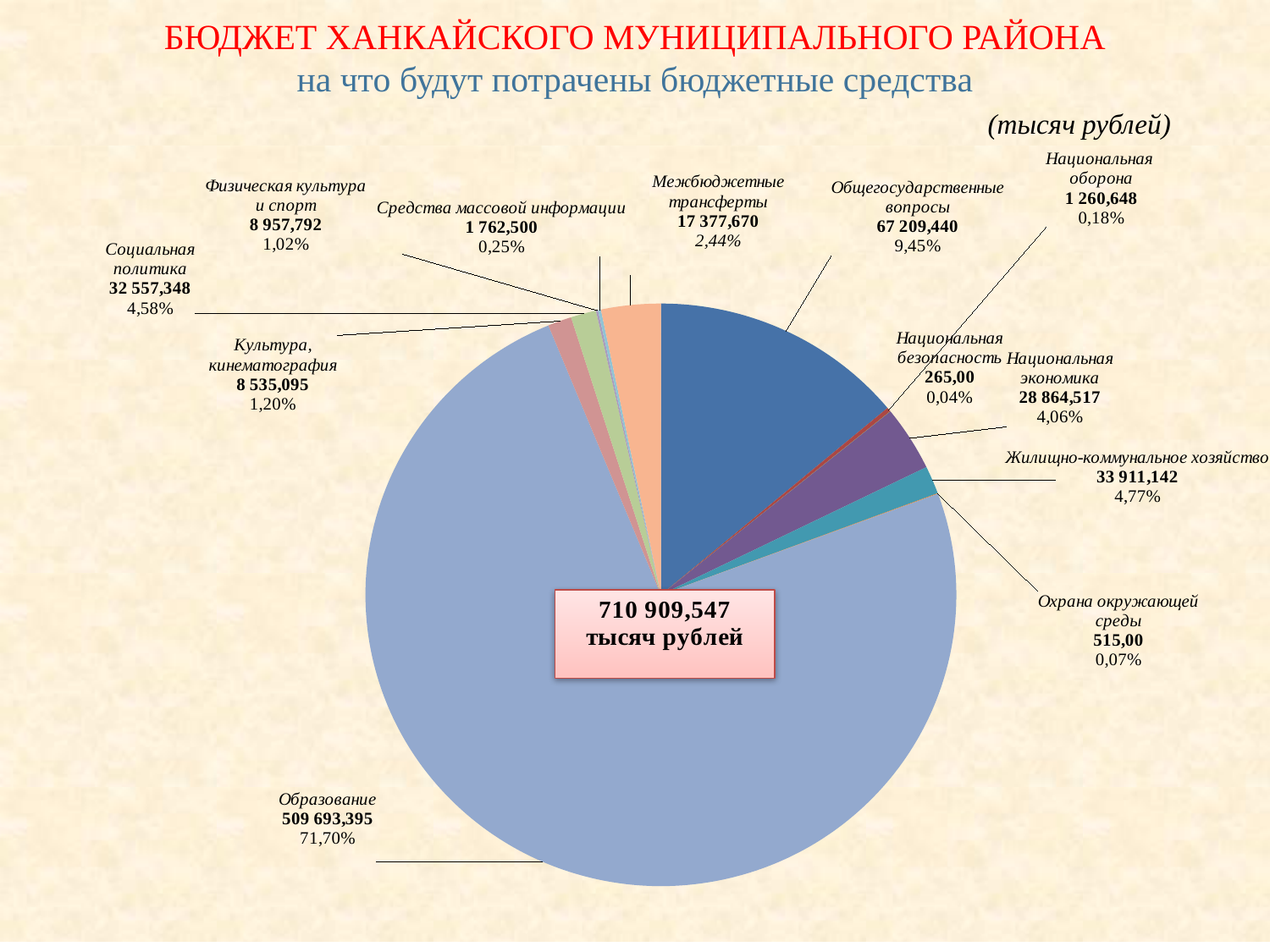
What is the value for Образование? 509 693,395 In what units are the values on the chart given, according to the slide? тысяч рублей What is the value for Общегосударственные вопросы? 67 209,440 Which category has the largest slice? Образование Which is larger, the value for Социальная политика or the value for Национальная экономика? Социальная политика How many categories (slices) does the pie chart have? 12 What is the difference between the values for Жилищно-коммунальное хозяйство and Социальная политика? 1 353,794 Which category has the smallest slice? Национальная безопасность What share of the pie does Жилищно-коммунальное хозяйство represent? 4,77% What is the total budget amount shown in the centre of the pie chart? 710 909,547 тысяч рублей What share of the pie does Образование represent? 71,70% What kind of chart is shown on the slide? Pie chart